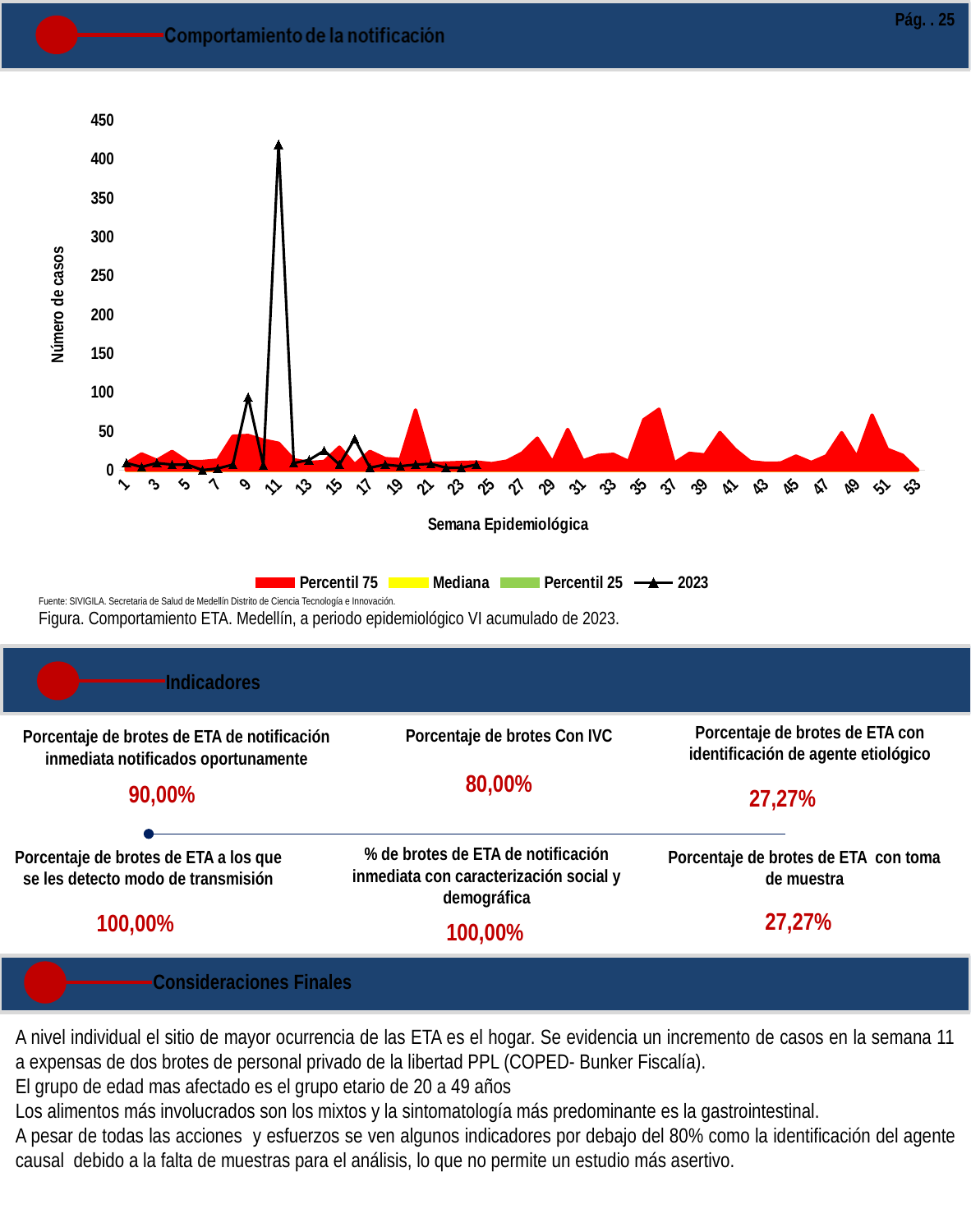
Which is larger for Percentil 75: the value in week 20 or the value in week 43? week 20 Is the value of the 2023 series in week 1 greater or less than 50? less Is the value of the 2023 series in week 11 greater or less than 400? greater Does the 2023 series rise or fall between week 11 and week 13? fall Is the Percentil 75 value in week 20 greater or less than 50? greater Which is larger for the 2023 series: the value in week 9 or the value in week 11? week 11 What colour is used for the Percentil 75 series in the legend? red In which epidemiological week does the 2023 series reach its highest value? 11 How many epidemiological weeks are shown on the x axis? 53 How many series does the legend list? 4 What is the title of the y axis? Número de casos